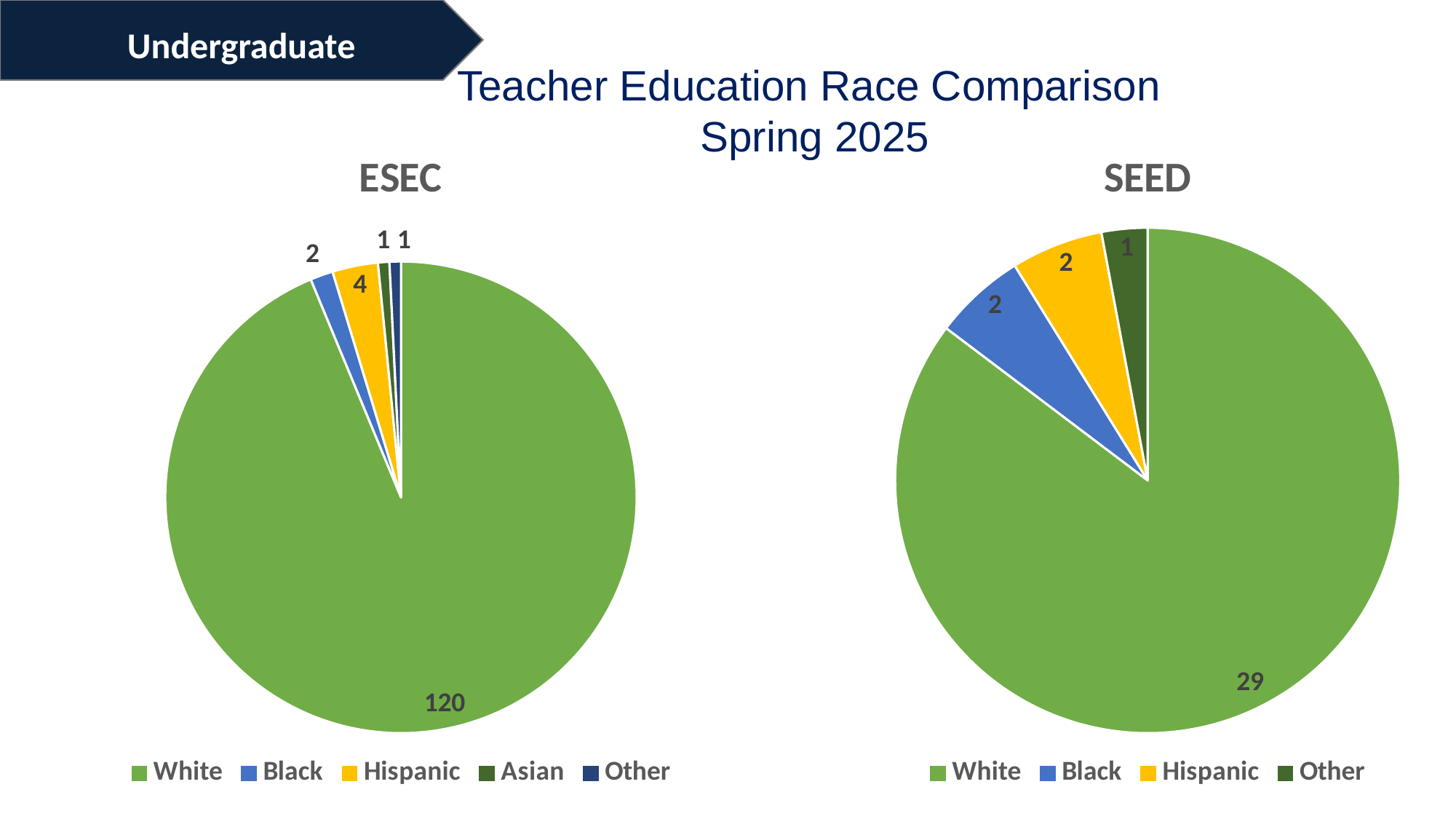
What is the difference between the White value in the ESEC chart and the White value in the SEED chart? 91 In the ESEC pie chart, which category has the largest slice? White In the SEED pie chart, what is the value for Black? 2 In the ESEC pie chart, what share of the total does the White slice represent? 93.75% In the SEED pie chart, what is the value for White? 29 What type of chart is used for ESEC? Pie chart In the ESEC pie chart, what is the difference between the White value and the Hispanic value? 116 In the ESEC pie chart, which is larger, the Hispanic slice or the Black slice? Hispanic In the ESEC pie chart, what is the value for Hispanic? 4 In the ESEC pie chart, what is the value for White? 120 How many categories does the SEED pie chart's legend list? 4 In the SEED pie chart, which category has the smallest slice? Other